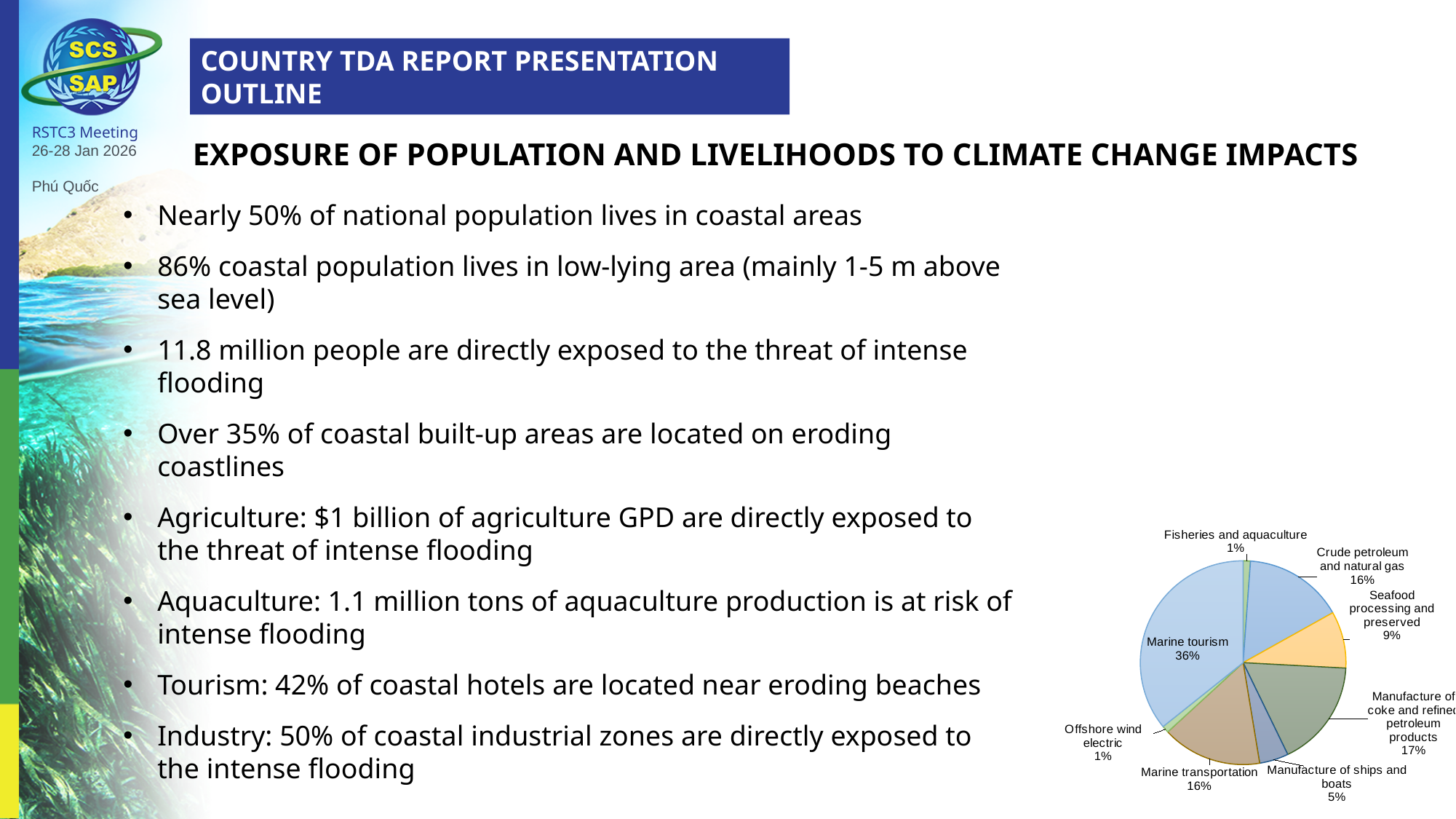
What is the difference between the Manufacture of coke and refined petroleum products share and the Manufacture of ships and boats share? 12% Which is larger in the pie chart, Crude petroleum and natural gas or Seafood processing and preserved? Crude petroleum and natural gas Which is larger in the pie chart, Marine transportation or Manufacture of ships and boats? Marine transportation What share of the pie does Manufacture of ships and boats have? 5% What share of the pie does Seafood processing and preserved have? 9% How many slices does the pie chart have? 8 What kind of chart is shown on the slide? pie chart What is the difference between the Marine tourism share and the Marine transportation share? 20% Which slice of the pie chart is the largest? Marine tourism What share of the pie does Manufacture of coke and refined petroleum products have? 17%